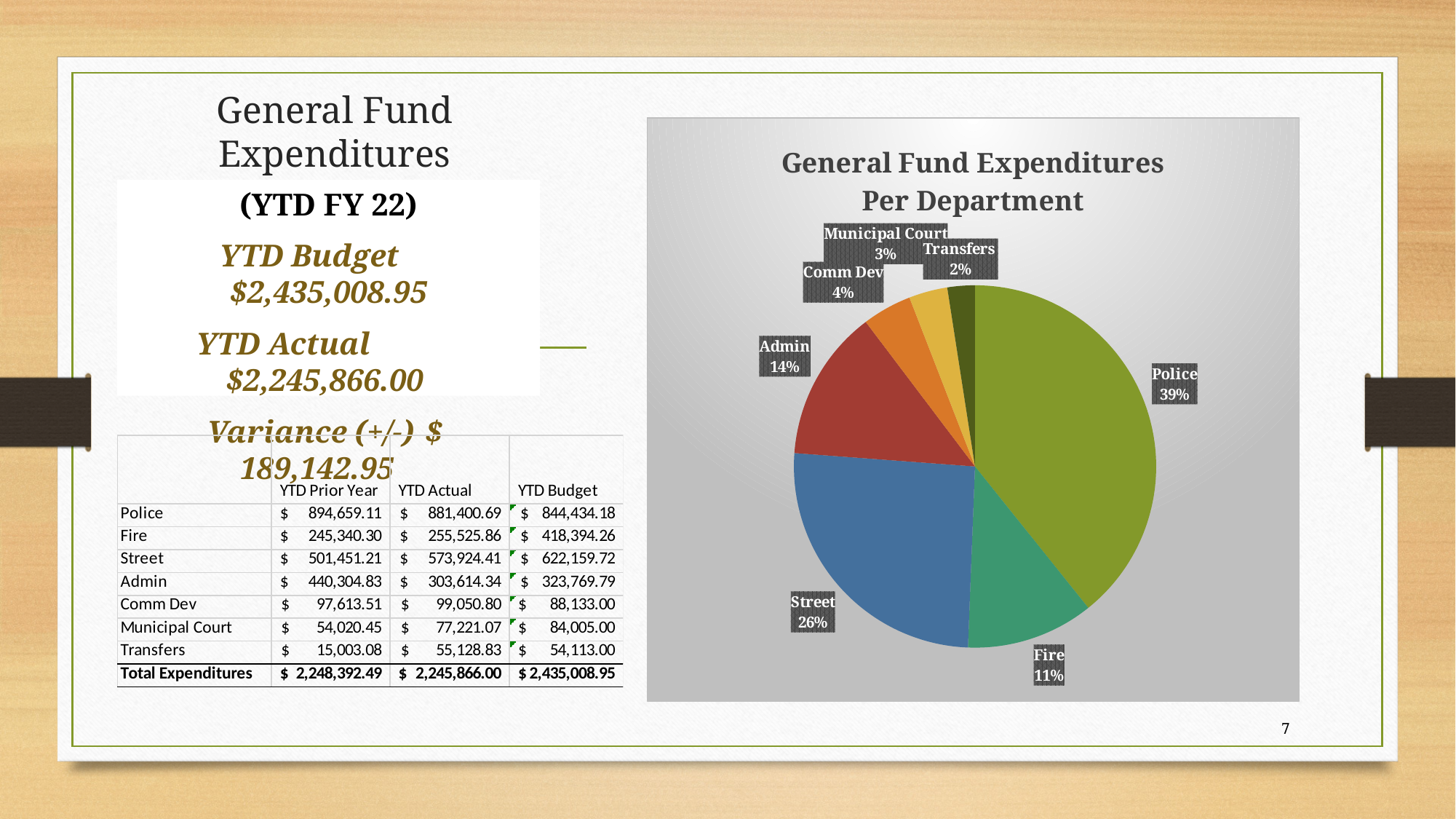
What share of the pie does Street account for? 26% Which slice is larger, Admin or Fire? Admin What percentage is shown for Fire in the pie chart? 11% What percentage is shown for Admin in the pie chart? 14% What share of the pie does Police account for? 39% What percentage is shown for Transfers in the pie chart? 2% How many departments (slices) are shown in the pie chart? 7 Which department has the largest slice of the pie? Police What is the difference in percentage points between the Police and Street slices? 13 Which department has the smallest slice of the pie? Transfers What type of chart is shown on the slide? Pie chart What is the title of the chart? General Fund Expenditures Per Department